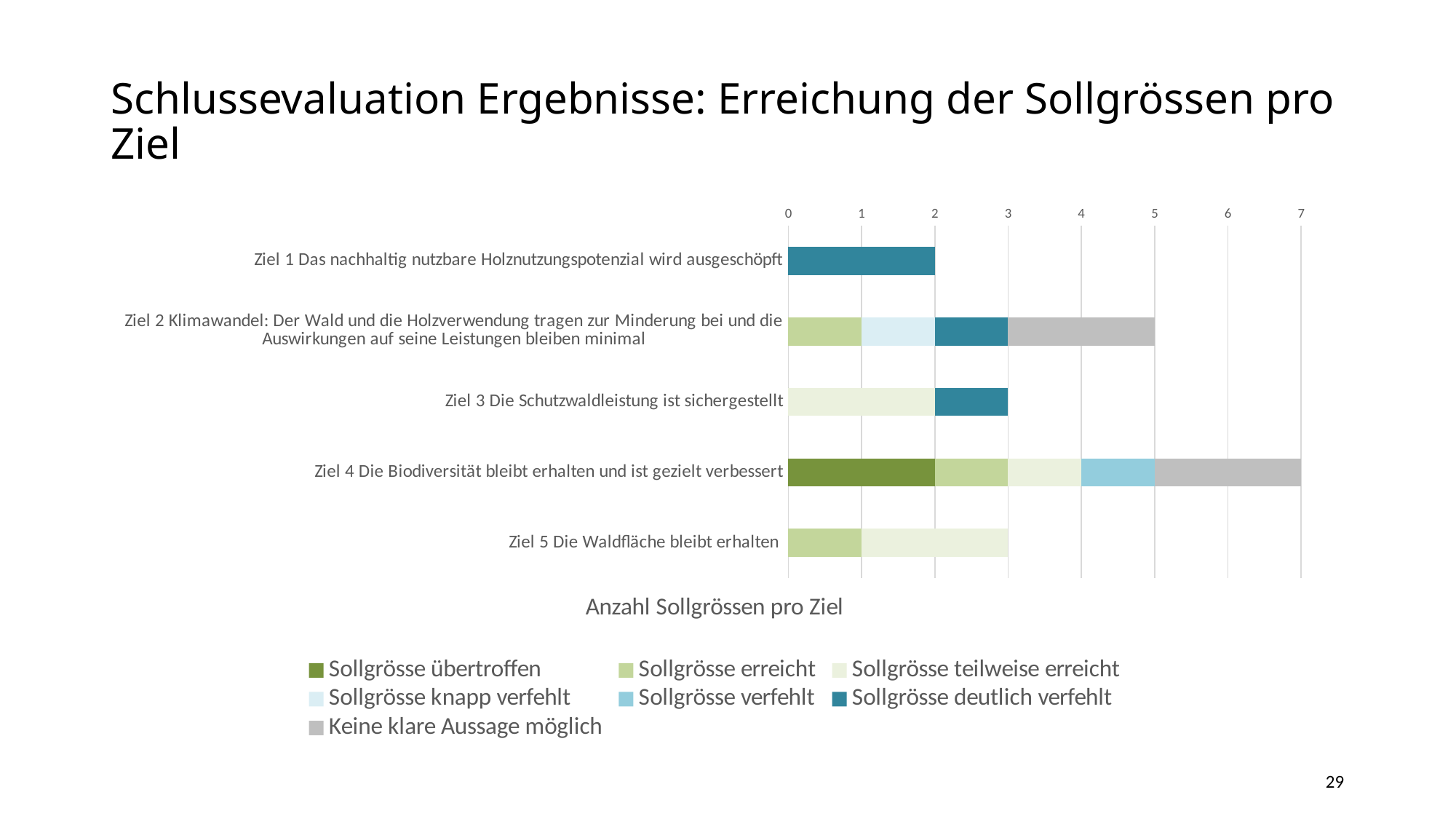
What is the total number of Sollgrössen for Ziel 2 Klimawandel? 5 What is the text shown below the chart as its title? Anzahl Sollgrössen pro Ziel What kind of chart is shown on the slide? Stacked bar chart Which goal has the highest total number of Sollgrössen? Ziel 4 Die Biodiversität bleibt erhalten und ist gezielt verbessert How many Sollgrössen for Ziel 5 Die Waldfläche bleibt erhalten are classified as 'Sollgrösse teilweise erreicht'? 2 Which goal has the lowest total number of Sollgrössen? Ziel 1 Das nachhaltig nutzbare Holznutzungspotenzial wird ausgeschöpft How many goals (Ziele) are listed as categories in the chart? 5 How many series does the legend list? 7 What is the total number of Sollgrössen for Ziel 4 Die Biodiversität bleibt erhalten und ist gezielt verbessert? 7 How many Sollgrössen for Ziel 4 are classified as 'Sollgrösse übertroffen'? 2 How many Sollgrössen for Ziel 1 are classified as 'Sollgrösse deutlich verfehlt'? 2 What is the difference between the total Sollgrössen of Ziel 4 and Ziel 3? 4